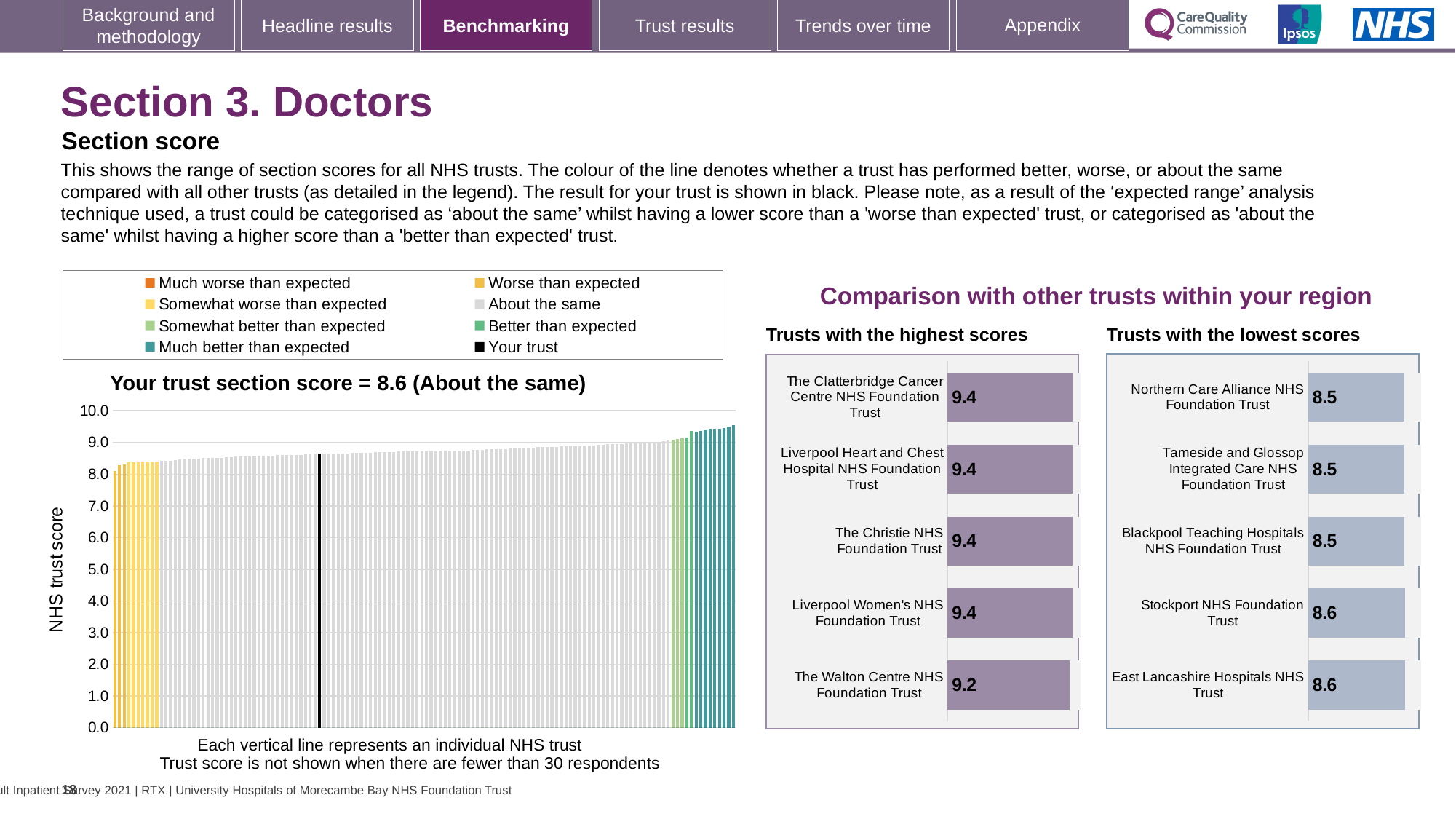
In the 'Trusts with the highest scores' chart, what is the score for The Walton Centre NHS Foundation Trust? 9.2 According to the title of the main chart on the left, what is your trust's section score? 8.6 How many entries does the legend above the main chart on the left list? 8 In the 'Trusts with the lowest scores' chart, what is the score for Blackpool Teaching Hospitals NHS Foundation Trust? 8.5 In the 'Trusts with the highest scores' chart, what is the score for The Christie NHS Foundation Trust? 9.4 In the 'Trusts with the lowest scores' chart, which has the higher score: Stockport NHS Foundation Trust or Northern Care Alliance NHS Foundation Trust? Stockport NHS Foundation Trust In the 'Trusts with the highest scores' chart, what is the difference between the scores of The Clatterbridge Cancer Centre NHS Foundation Trust and The Walton Centre NHS Foundation Trust? 0.2 How many trusts are shown in the 'Trusts with the lowest scores' chart? 5 In the 'Trusts with the highest scores' chart, which trust has the lowest score? The Walton Centre NHS Foundation Trust What kind of chart is the main chart on the left showing all NHS trusts? bar chart In the 'Trusts with the lowest scores' chart, what is the score for Stockport NHS Foundation Trust? 8.6 In the main chart on the left, is the value of the highest bar greater or less than 9.0? greater